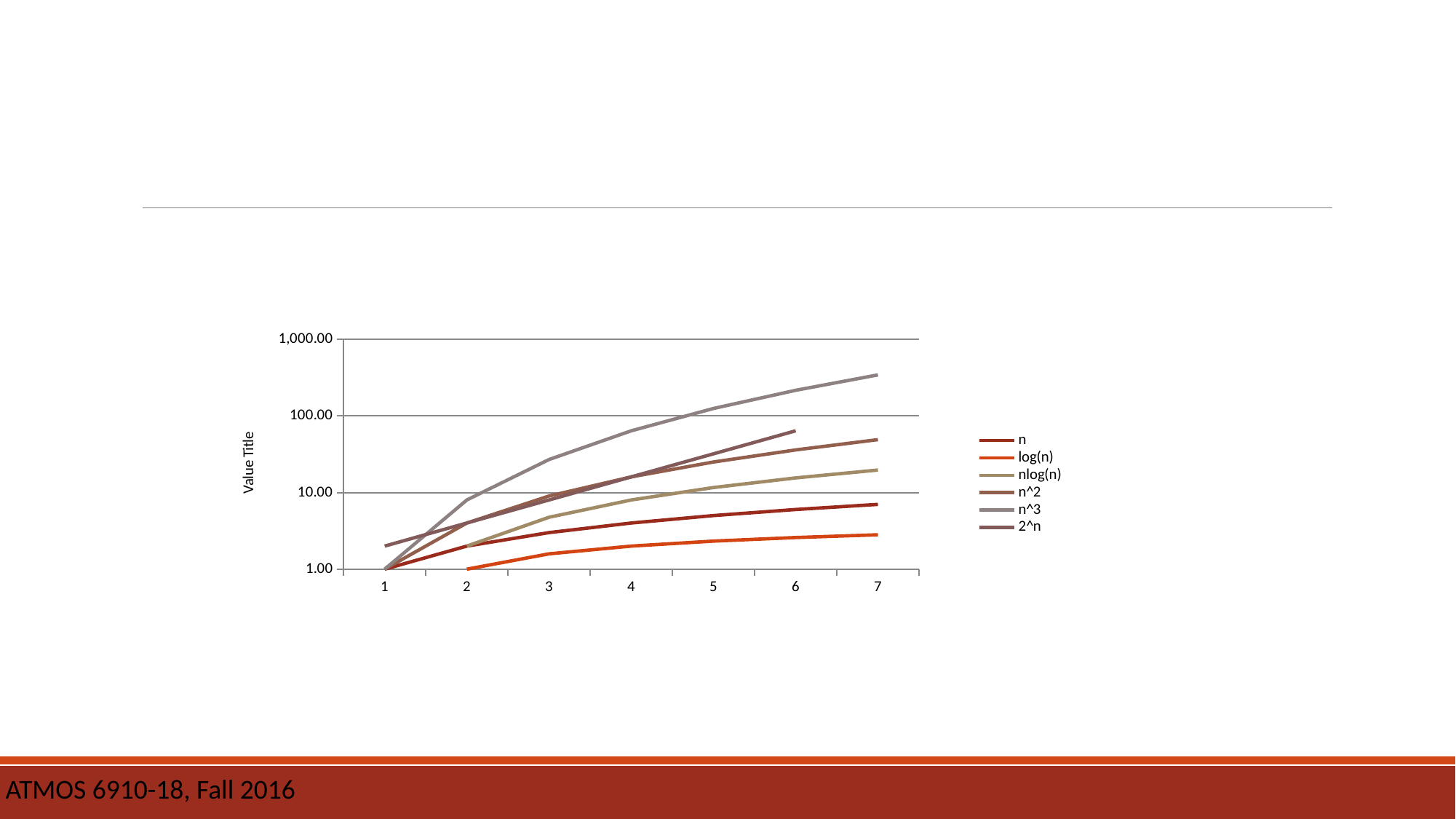
Is the value for nlog(n) at x = 7 greater or less than 10? greater What is the title of the vertical axis? Value Title Which series has the highest value at x = 7? n^3 Is the value for n^3 at x = 7 greater or less than 100? greater Which series has the lowest value at x = 7? log(n) How many points are labelled along the x axis? 7 Is the value for n^2 at x = 7 greater or less than 100? less What kind of chart is shown on the slide? line chart At x = 7, which is larger, n^3 or n^2? n^3 Do the values of the n^3 series rise or fall as x increases from 1 to 7? rise How many series does the legend list? 6